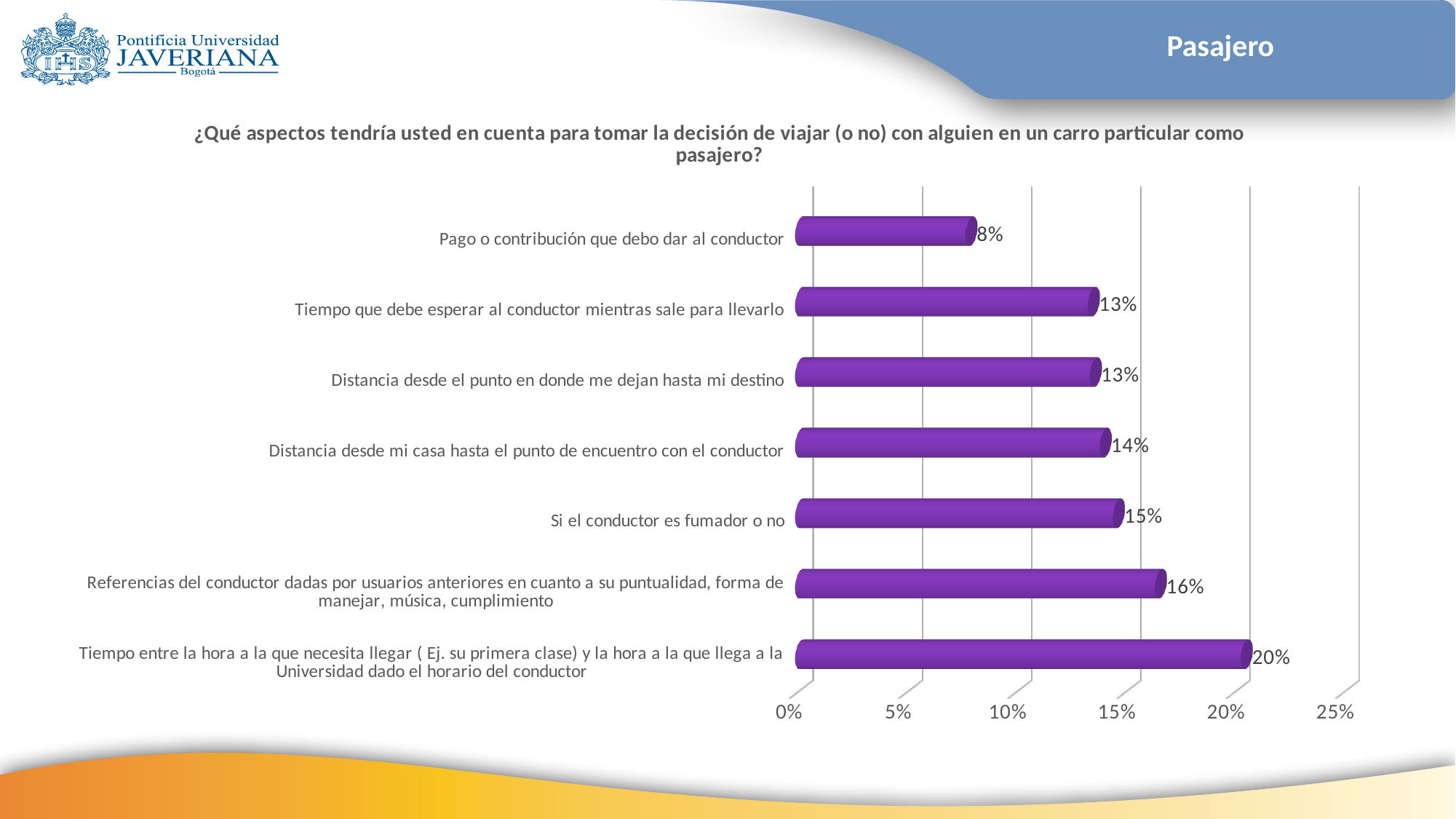
What is the title of the chart? ¿Qué aspectos tendría usted en cuenta para tomar la decisión de viajar (o no) con alguien en un carro particular como pasajero? Which category has the lowest value? Pago o contribución que debo dar al conductor What is the value for "Pago o contribución que debo dar al conductor"? 8% What is the difference between the value for "Tiempo entre la hora a la que necesita llegar ( Ej. su primera clase) y la hora a la que llega a la Universidad dado el horario del conductor" and the value for "Pago o contribución que debo dar al conductor"? 12% What is the value for "Distancia desde mi casa hasta el punto de encuentro con el conductor"? 14% What is the value for "Si el conductor es fumador o no"? 15% What kind of chart is shown on the slide? bar chart Is the value for "Referencias del conductor dadas por usuarios anteriores en cuanto a su puntualidad, forma de manejar, música, cumplimiento" greater or less than 15%? greater How many categories are shown in the chart? 7 Which category has the highest value? Tiempo entre la hora a la que necesita llegar ( Ej. su primera clase) y la hora a la que llega a la Universidad dado el horario del conductor What is the value for "Referencias del conductor dadas por usuarios anteriores en cuanto a su puntualidad, forma de manejar, música, cumplimiento"? 16% Which is larger: the value for "Si el conductor es fumador o no" or the value for "Distancia desde el punto en donde me dejan hasta mi destino"? Si el conductor es fumador o no